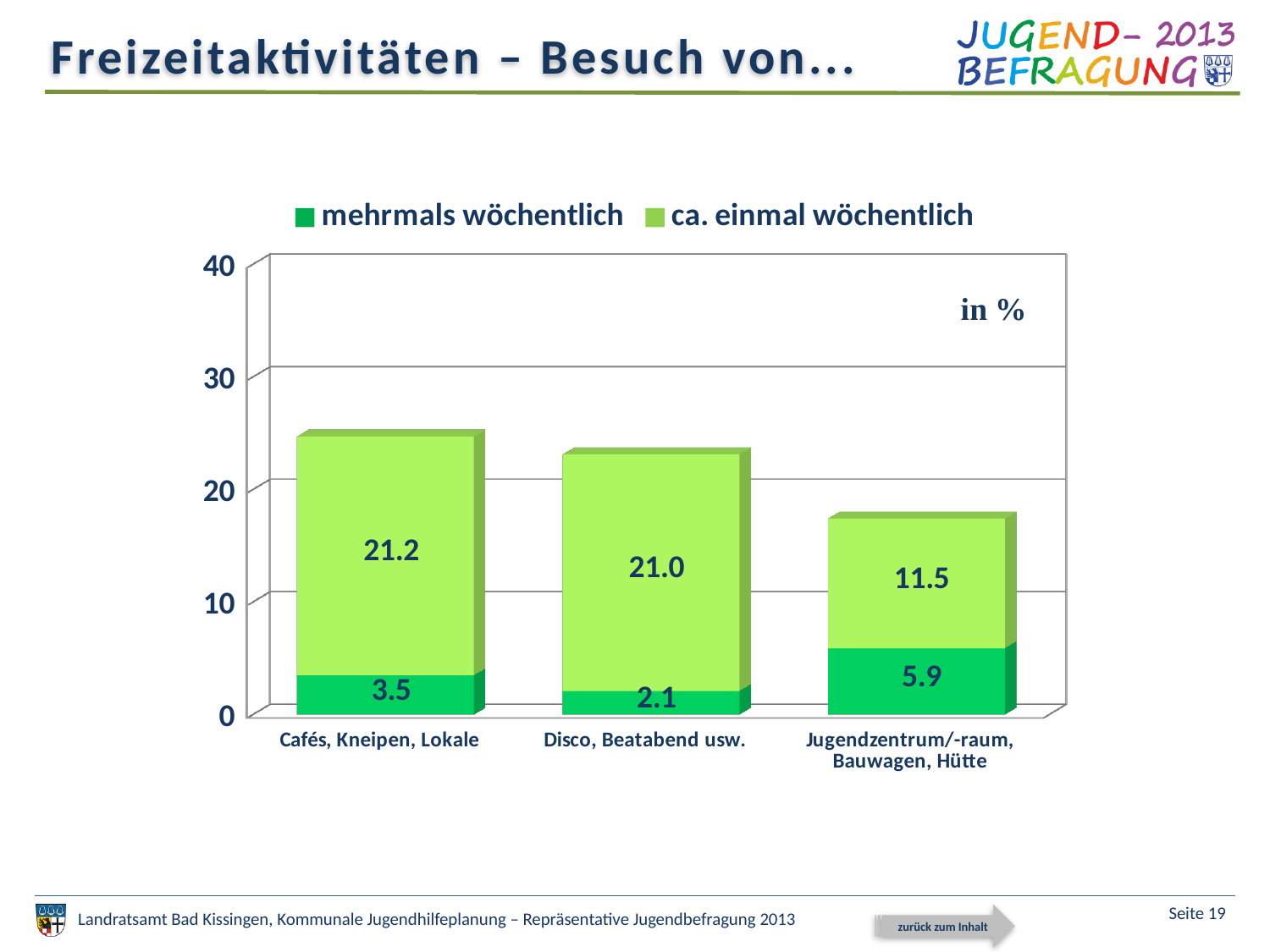
Which category has the lowest value for "ca. einmal wöchentlich"? Jugendzentrum/-raum, Bauwagen, Hütte How many series does the legend list? 2 What is the value for "mehrmals wöchentlich" for Disco, Beatabend usw.? 2.1 What is the value for "mehrmals wöchentlich" for Jugendzentrum/-raum, Bauwagen, Hütte? 5.9 How many categories are shown on the x axis? 3 What is the value for "ca. einmal wöchentlich" for Cafés, Kneipen, Lokale? 21.2 What is the total of the stacked bar for Jugendzentrum/-raum, Bauwagen, Hütte? 17.4 What is the total of the stacked bar for Cafés, Kneipen, Lokale? 24.7 What kind of chart is shown on the slide? Stacked bar chart What is the difference between the "ca. einmal wöchentlich" values for Cafés, Kneipen, Lokale and Jugendzentrum/-raum, Bauwagen, Hütte? 9.7 Which is larger: the "mehrmals wöchentlich" value for Cafés, Kneipen, Lokale or for Disco, Beatabend usw.? Cafés, Kneipen, Lokale Which category has the highest value for "mehrmals wöchentlich"? Jugendzentrum/-raum, Bauwagen, Hütte